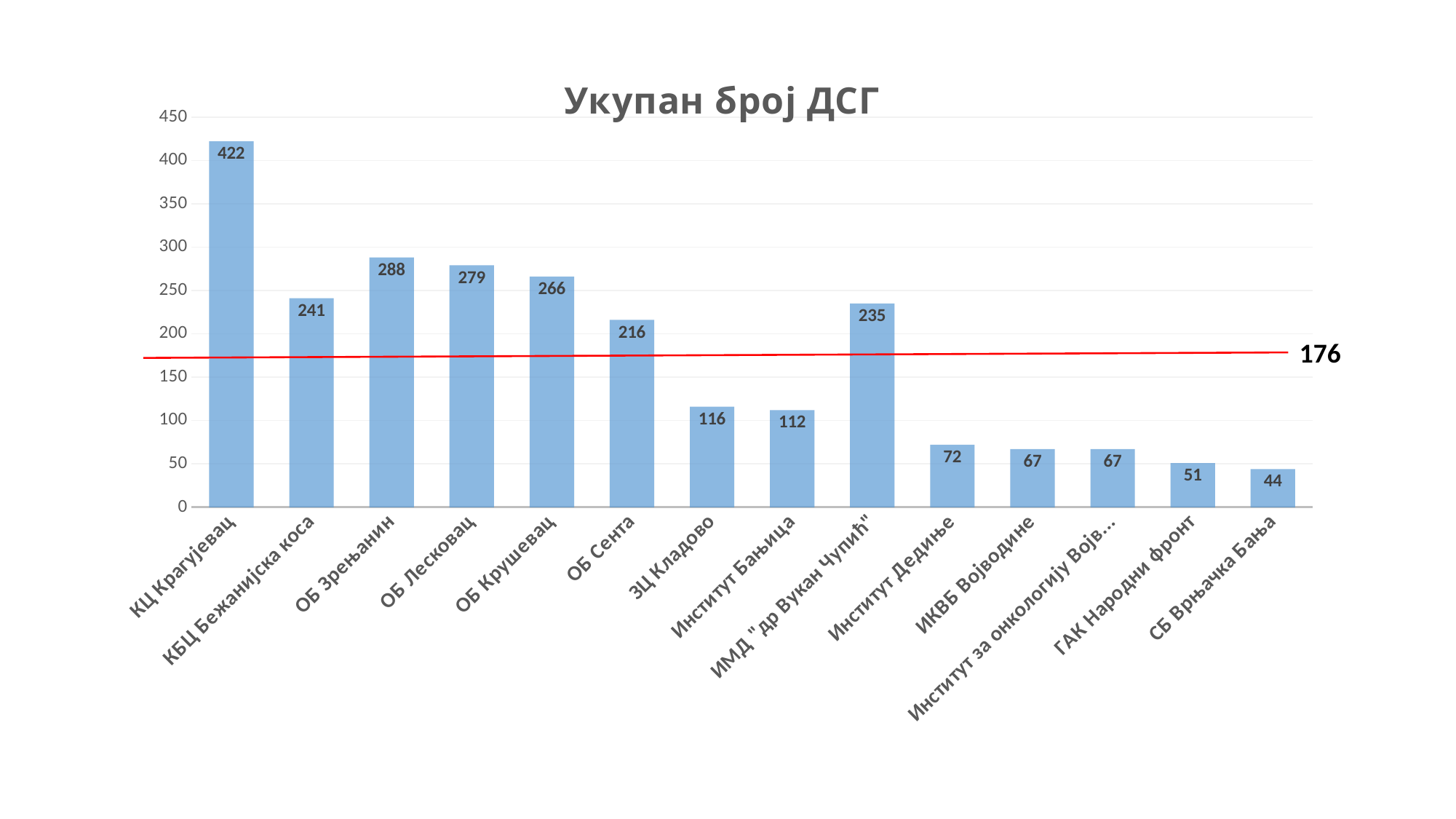
What is the title of the chart? Укупан број ДСГ How many categories are shown on the x axis? 14 Which category has the highest value? КЦ Крагујевац What is the value for Институт Бањица? 112 Is the value for ЗЦ Кладово greater or less than 150? less What is the difference between the values for ОБ Зрењанин and ОБ Лесковац? 9 What is the value for КЦ Крагујевац? 422 What kind of chart is this? bar chart Which category has the lowest value? СБ Врњачка Бања What value is labelled on the red horizontal line? 176 Which is larger, the value for КБЦ Бежанијска коса or the value for ИМД "др Вукан Чупић"? КБЦ Бежанијска коса What is the value for ОБ Сента? 216